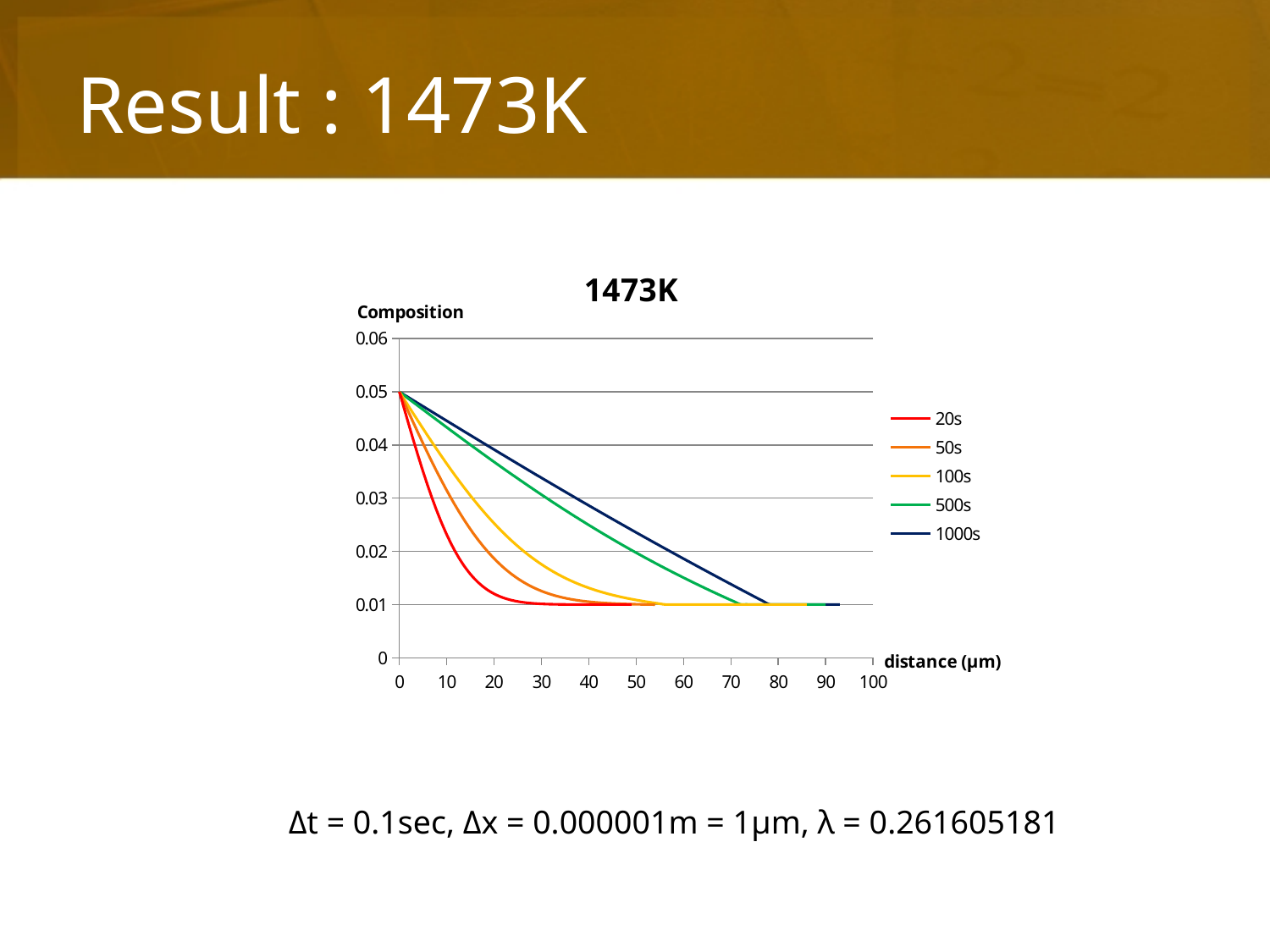
What is the title of the chart? 1473K What composition value does the 1000s series level off at for large distances? 0.01 What is the composition value of the 20s series at distance 0? 0.05 Do the composition values rise or fall as distance increases? fall At distance 30, which series has the higher composition, 20s or 1000s? 1000s What is the label of the x axis? distance (μm) What kind of chart is shown on the slide? line chart Is the value for the 100s series at distance 40 greater or less than 0.02? less Is the value for the 1000s series at distance 10 greater or less than 0.04? greater How many series does the legend list? 5 Is the value for the 20s series at distance 30 greater or less than 0.02? less At distance 20, which series has the higher composition, 50s or 500s? 500s